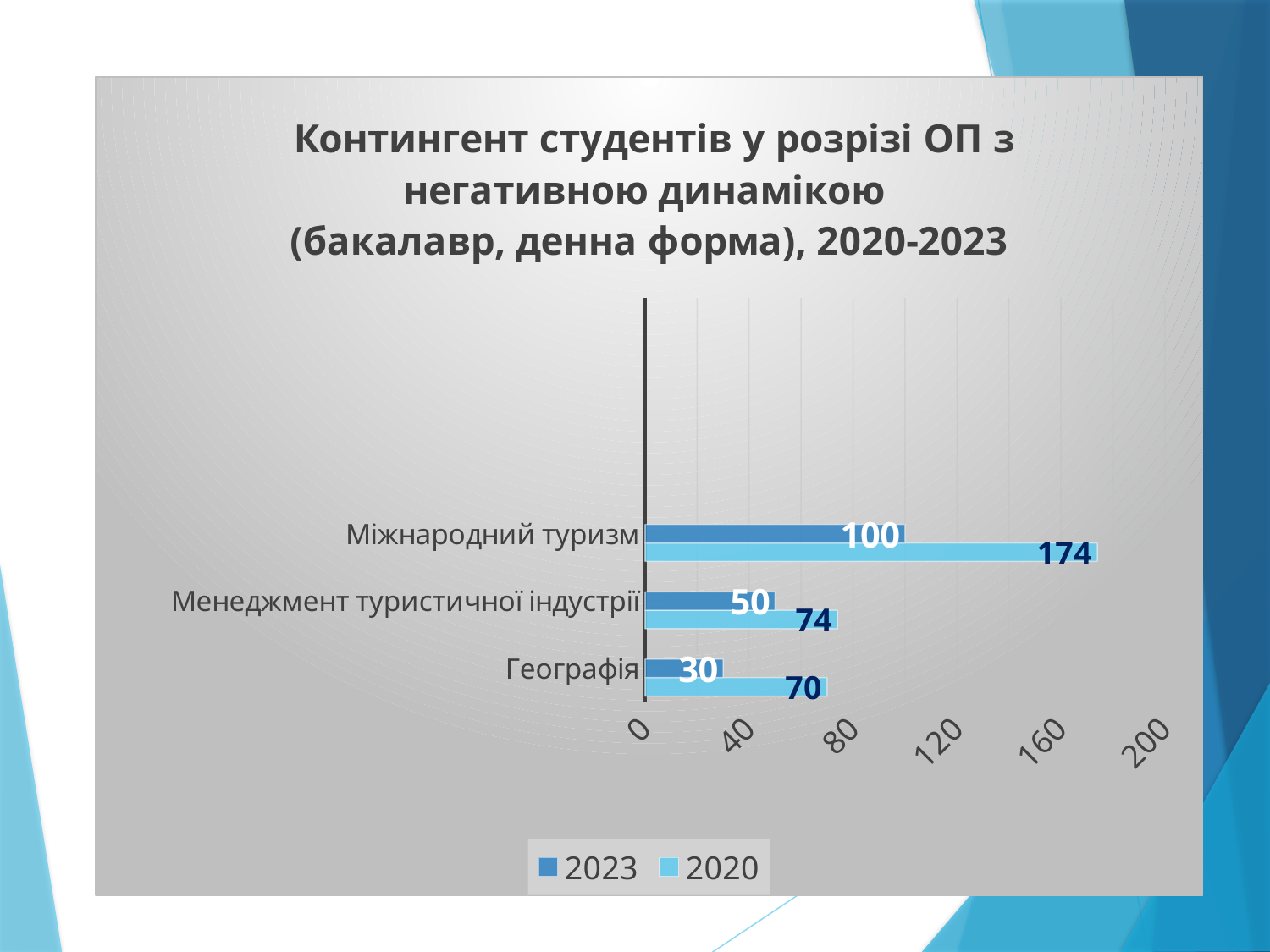
How many series does the legend list? 2 Which category has the lowest value in 2023? Географія What is the value for Міжнародний туризм in 2020? 174 Which is larger: the 2020 value for Географія or the 2020 value for Менеджмент туристичної індустрії? Менеджмент туристичної індустрії What is the value for Менеджмент туристичної індустрії in 2020? 74 Which category has the highest value in 2020? Міжнародний туризм What is the difference between the 2020 and 2023 values for Міжнародний туризм? 74 What is the value for Міжнародний туризм in 2023? 100 What is the value for Географія in 2023? 30 What is the difference between the 2020 and 2023 values for Географія? 40 How many categories are shown on the chart? 3 What kind of chart is shown on the slide? Bar chart